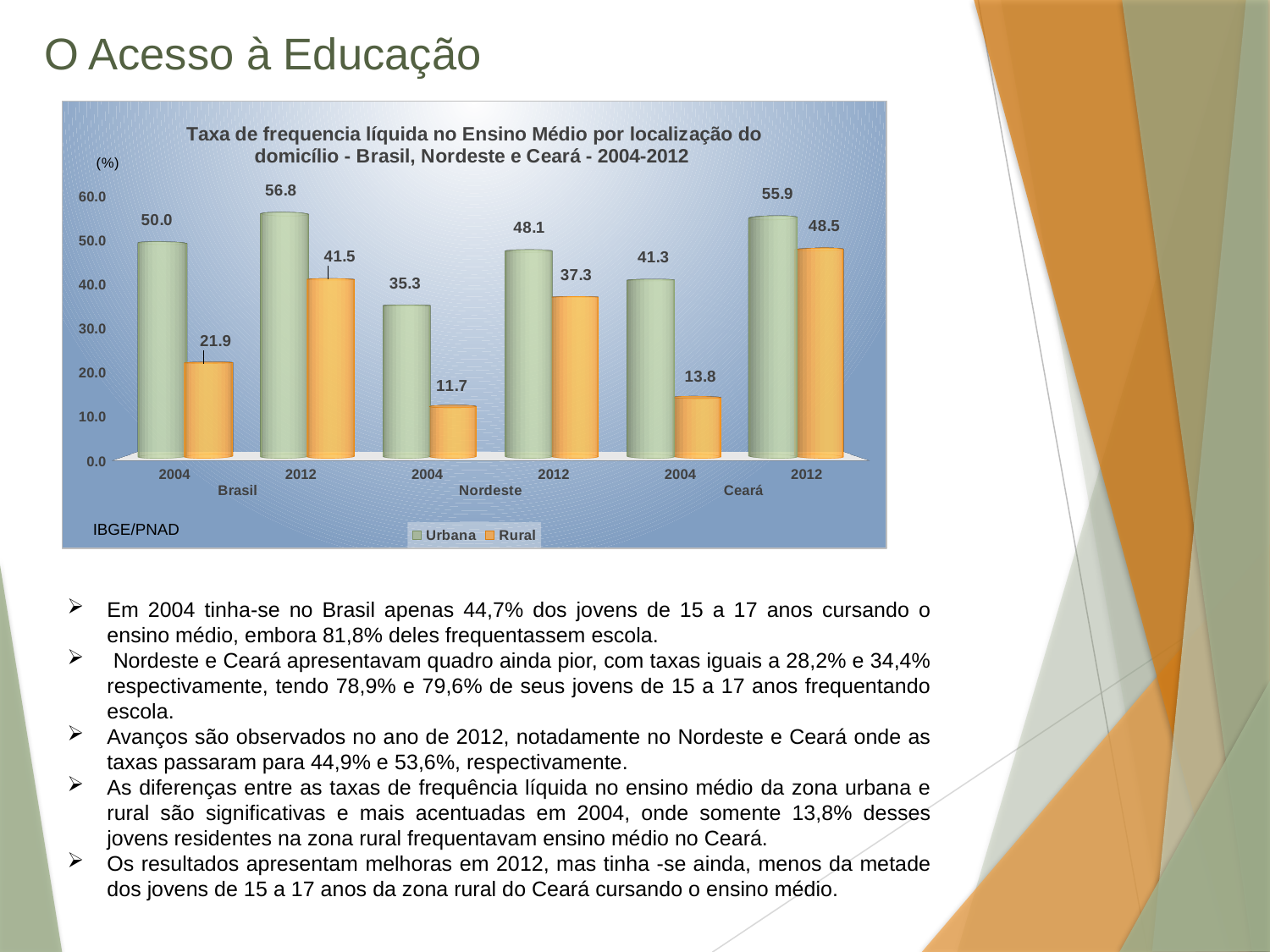
What source is cited at the bottom left of the chart? IBGE/PNAD What is the Rural value for Ceará in 2012? 48.5 Which category has the lowest Rural value? Nordeste 2004 What is the Rural value for Nordeste in 2004? 11.7 How many series does the legend list? 2 Which is larger, the Rural value for Brasil in 2012 or the Rural value for Nordeste in 2012? Brasil 2012 Does the Rural value for Nordeste rise or fall from 2004 to 2012? Rise What is the Urbana value for Brasil in 2004? 50.0 How many year-region categories are shown on the x axis? 6 What is the difference between the Urbana and Rural values for Ceará in 2004? 27.5 What kind of chart is shown? Bar chart Which category has the highest Urbana value? Brasil 2012